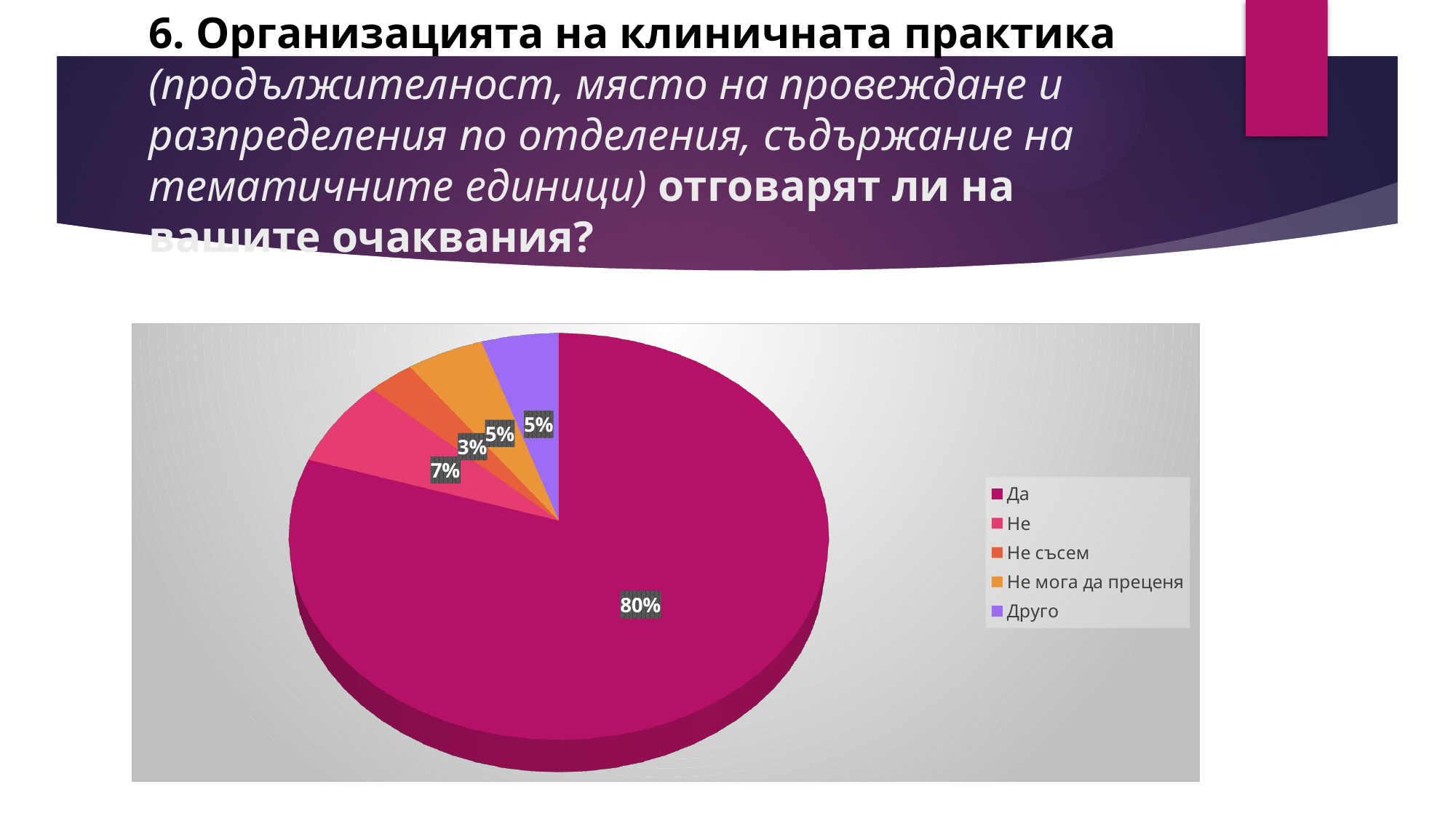
What share of the pie does the "Не" slice represent? 7% What kind of chart is shown on the slide? pie chart What share of the pie does the "Друго" slice represent? 5% Which category has the largest slice of the pie? Да Which category has the smallest slice of the pie? Не съсем How many categories does the legend of the pie chart list? 5 What is the difference in percentage points between the "Да" slice and the "Не" slice? 73 What share of the pie does the "Не мога да преценя" slice represent? 5% What colour is the "Друго" slice in the pie chart? purple Which slice is larger, "Не" or "Не съсем"? Не